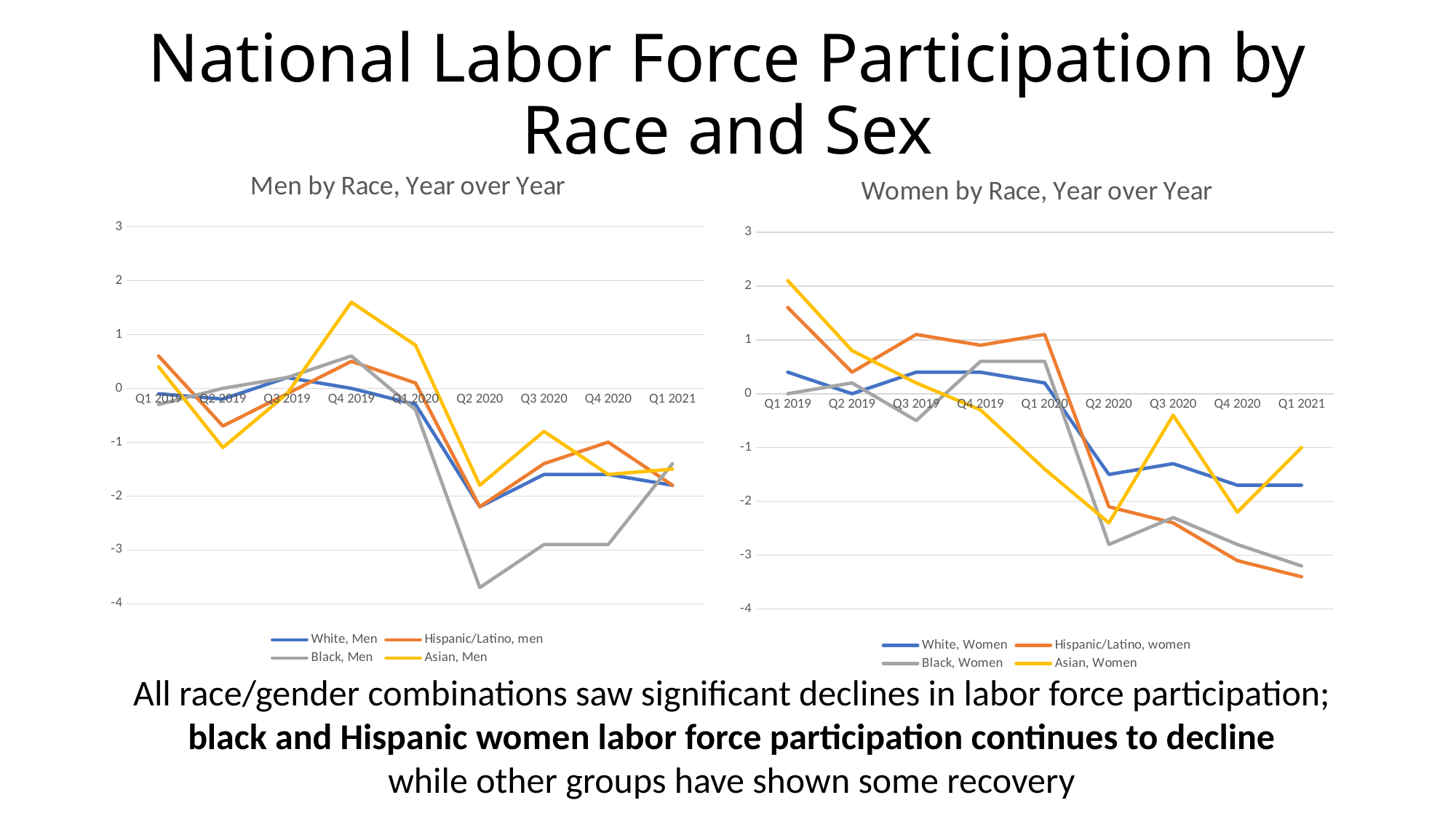
In the 'Women by Race, Year over Year' chart, which is higher in Q1 2021: Asian, Women or Hispanic/Latino, women? Asian, Women How many quarters are shown on the x axis of the 'Men by Race, Year over Year' chart? 9 In the 'Men by Race, Year over Year' chart, which series reaches the highest value? Asian, Men How many series does the legend of the 'Women by Race, Year over Year' chart list? 4 In the 'Men by Race, Year over Year' chart, which series reaches the lowest value? Black, Men What type of chart is the 'Men by Race, Year over Year' chart? line chart In the 'Women by Race, Year over Year' chart, which series has the lowest value in Q1 2021? Hispanic/Latino, women In the 'Women by Race, Year over Year' chart, is the value for Hispanic/Latino, women in Q1 2021 greater or less than -3? less In the 'Women by Race, Year over Year' chart, does the Hispanic/Latino, women line rise or fall from Q1 2020 to Q1 2021? fall In the 'Men by Race, Year over Year' chart, is the value for Black, Men in Q2 2020 greater or less than -3? less What colour is the Black, Men line in the 'Men by Race, Year over Year' chart? gray